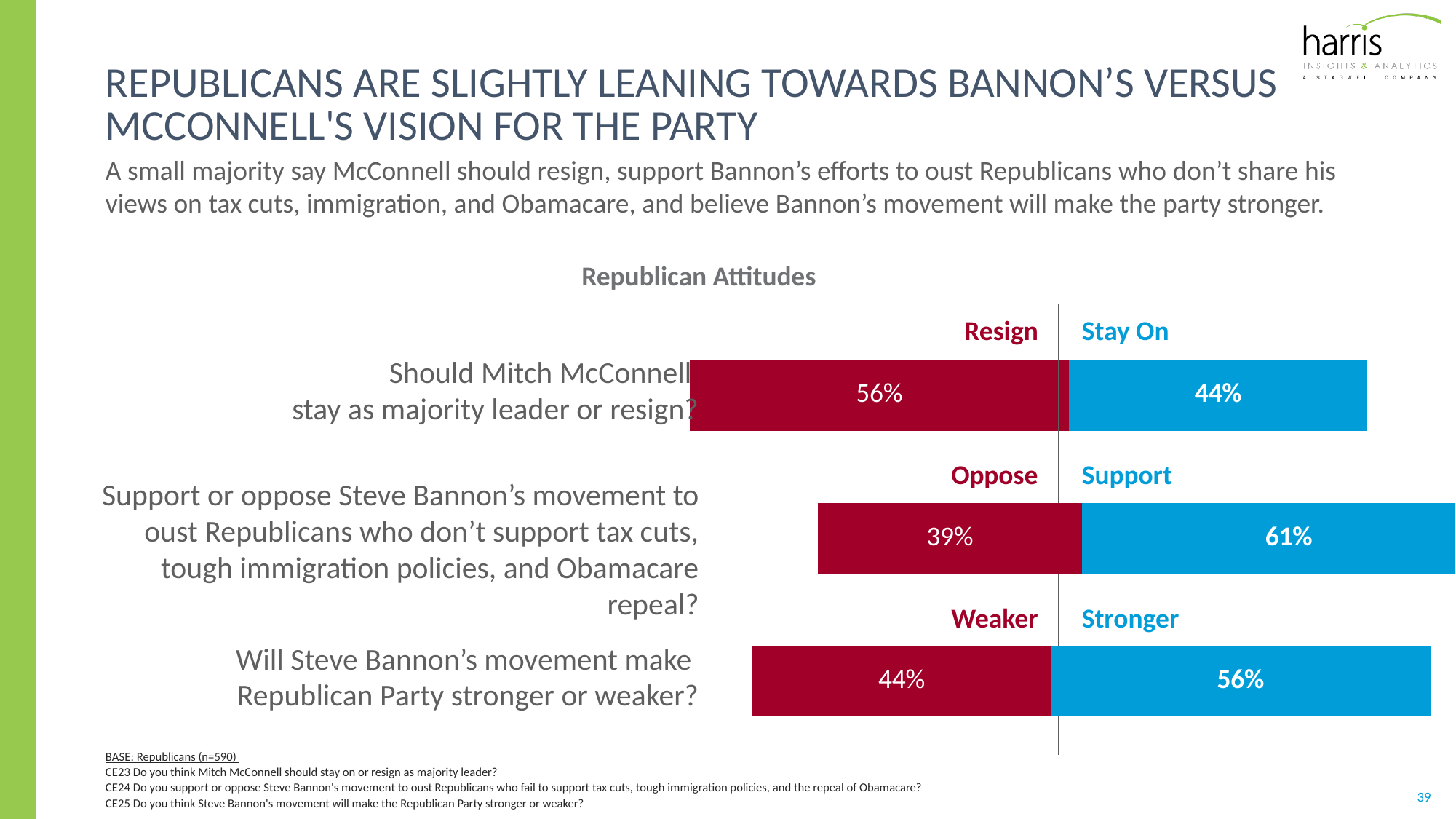
What percentage of Republicans say Mitch McConnell should resign as majority leader? 56% Which response has the lowest percentage in the chart? Oppose (39%) What percentage of Republicans support Steve Bannon's movement to oust Republicans who don't support tax cuts, tough immigration policies, and Obamacare repeal? 61% What percentage of Republicans think Steve Bannon's movement will make the Republican Party stronger? 56% Which is larger: the share saying McConnell should resign or the share saying he should stay on? Resign What percentage of Republicans oppose Steve Bannon's movement? 39% What is the difference between the share who support and the share who oppose Bannon's movement? 22 percentage points Which response has the highest percentage in the chart? Support (61%) What percentage of Republicans say Mitch McConnell should stay on as majority leader? 44% What percentage of Republicans think Steve Bannon's movement will make the Republican Party weaker? 44% How many questions (categories) are shown in the chart? 3 What is the title of the chart? Republican Attitudes